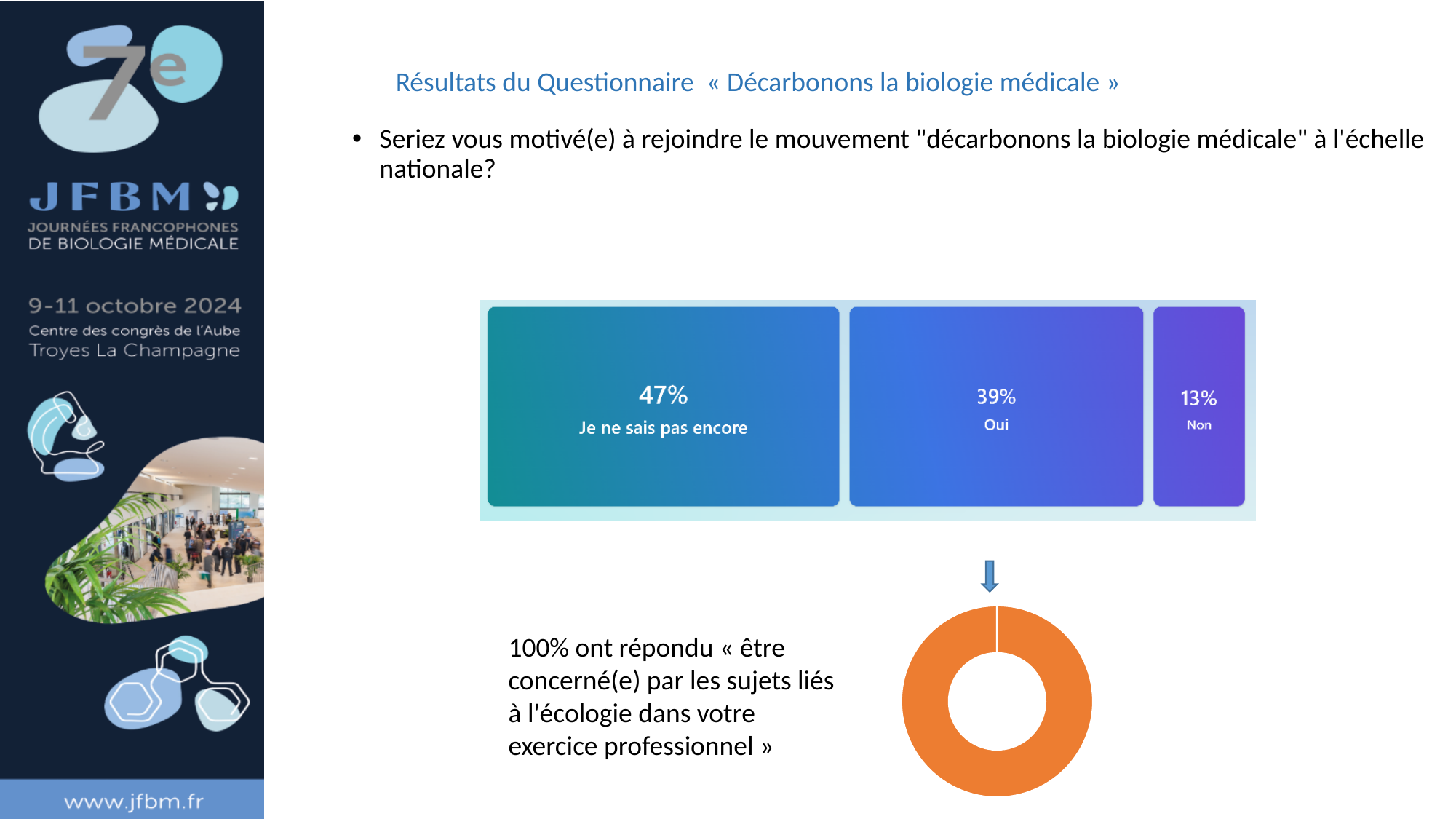
In the upper chart, what percentage of respondents answered "Oui"? 39% How many response categories are shown in the upper chart? 3 In the upper chart, what is the difference in percentage points between "Je ne sais pas encore" and "Oui"? 8 In the upper chart, what percentage of respondents answered "Non"? 13% What colour is the lower donut chart? Orange In the upper chart, which response has the highest percentage? Je ne sais pas encore In the upper chart, which is larger: the share for "Oui" or the share for "Non"? Oui In the upper chart, what is the difference in percentage points between "Oui" and "Non"? 26 In the upper chart, what percentage of respondents answered "Je ne sais pas encore"? 47% In the upper chart, which response has the lowest percentage? Non What kind of chart is the lower chart next to the text "100% ont répondu"? Donut chart What percentage does the lower donut chart represent, according to the text beside it? 100%